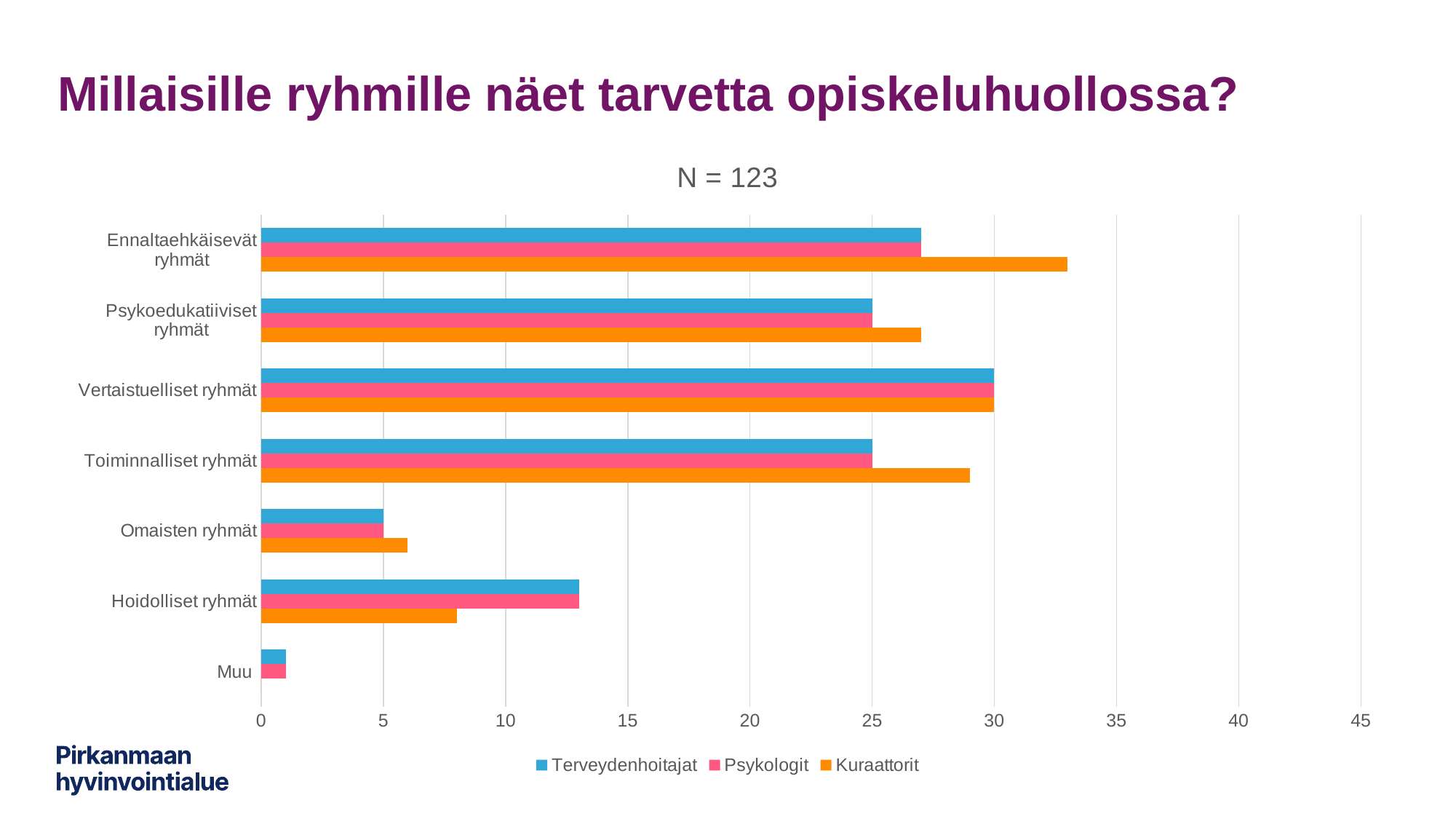
What kind of chart is shown on the slide? bar chart What is the sample size stated above the chart? N = 123 What is the value for Psykologit in the Toiminnalliset ryhmät category? 25 What is the value for Terveydenhoitajat in the Omaisten ryhmät category? 5 Is the value for Kuraattorit in the Ennaltaehkäisevät ryhmät category greater or less than 30? greater What is the value for Terveydenhoitajat in the Vertaistuelliset ryhmät category? 30 Which category has the lowest value for Terveydenhoitajat? Muu How many categories are shown on the vertical axis? 7 How many series does the legend list? 3 Is the value for Kuraattorit in the Hoidolliset ryhmät category greater or less than 10? less In the Hoidolliset ryhmät category, which is larger: the value for Terveydenhoitajat or for Kuraattorit? Terveydenhoitajat Which category has the highest value for Kuraattorit? Ennaltaehkäisevät ryhmät